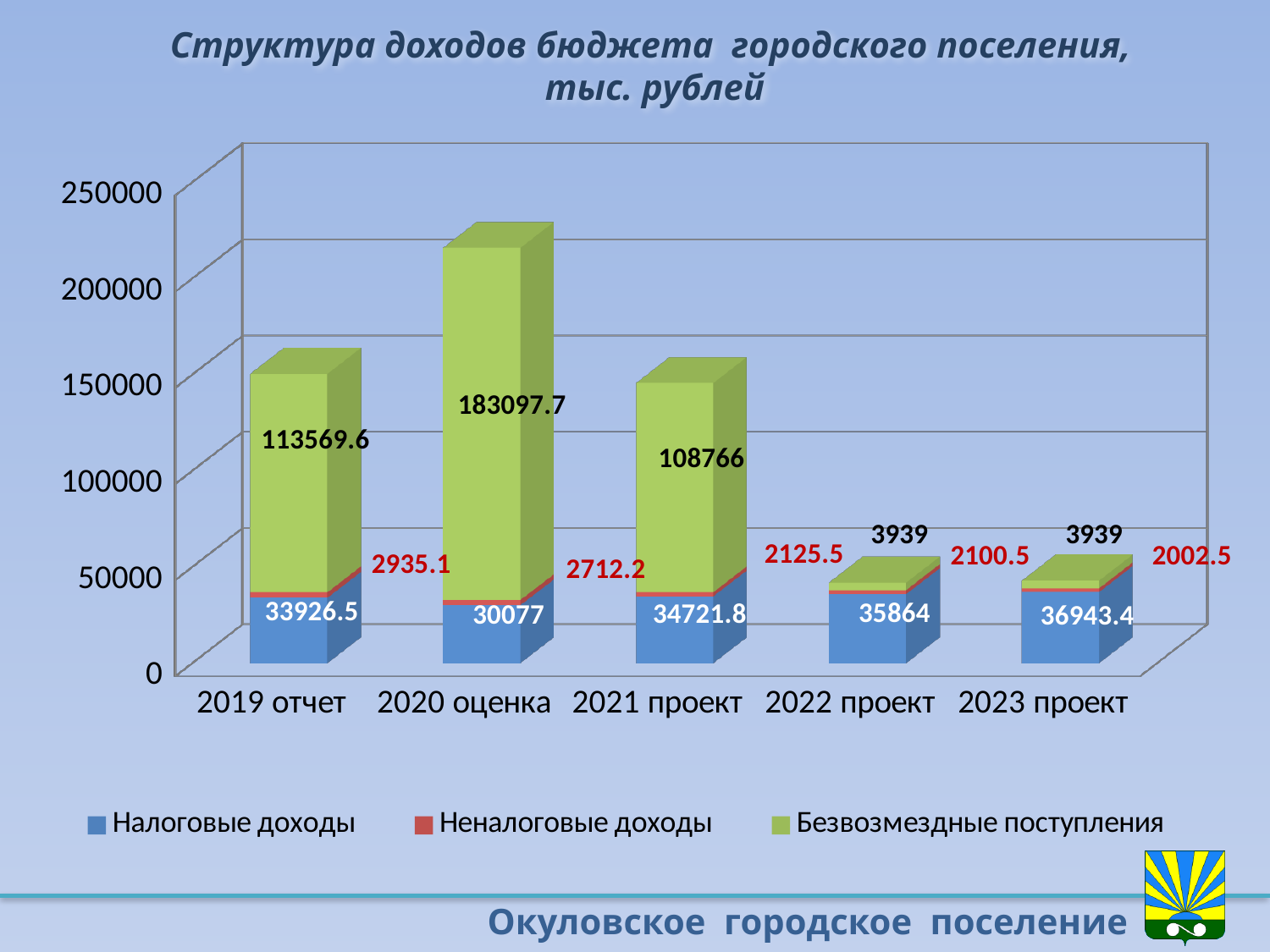
What is the value of Безвозмездные поступления for 2020 оценка? 183097.7 Which category has the lowest value for Налоговые доходы? 2020 оценка Which category has the highest value for Безвозмездные поступления? 2020 оценка Which is larger: Неналоговые доходы for 2019 отчет or for 2021 проект? 2019 отчет What kind of chart is shown on the slide? Stacked bar chart What is the total of the stacked bar for 2022 проект? 41903.5 What is the value of Неналоговые доходы for 2023 проект? 2002.5 What is the difference between Налоговые доходы for 2023 проект and 2019 отчет? 3016.9 Is the total height of the 2020 оценка bar greater or less than 200000? greater How many categories are shown on the x axis? 5 How many series does the legend list? 3 What is the value of Налоговые доходы for 2019 отчет? 33926.5